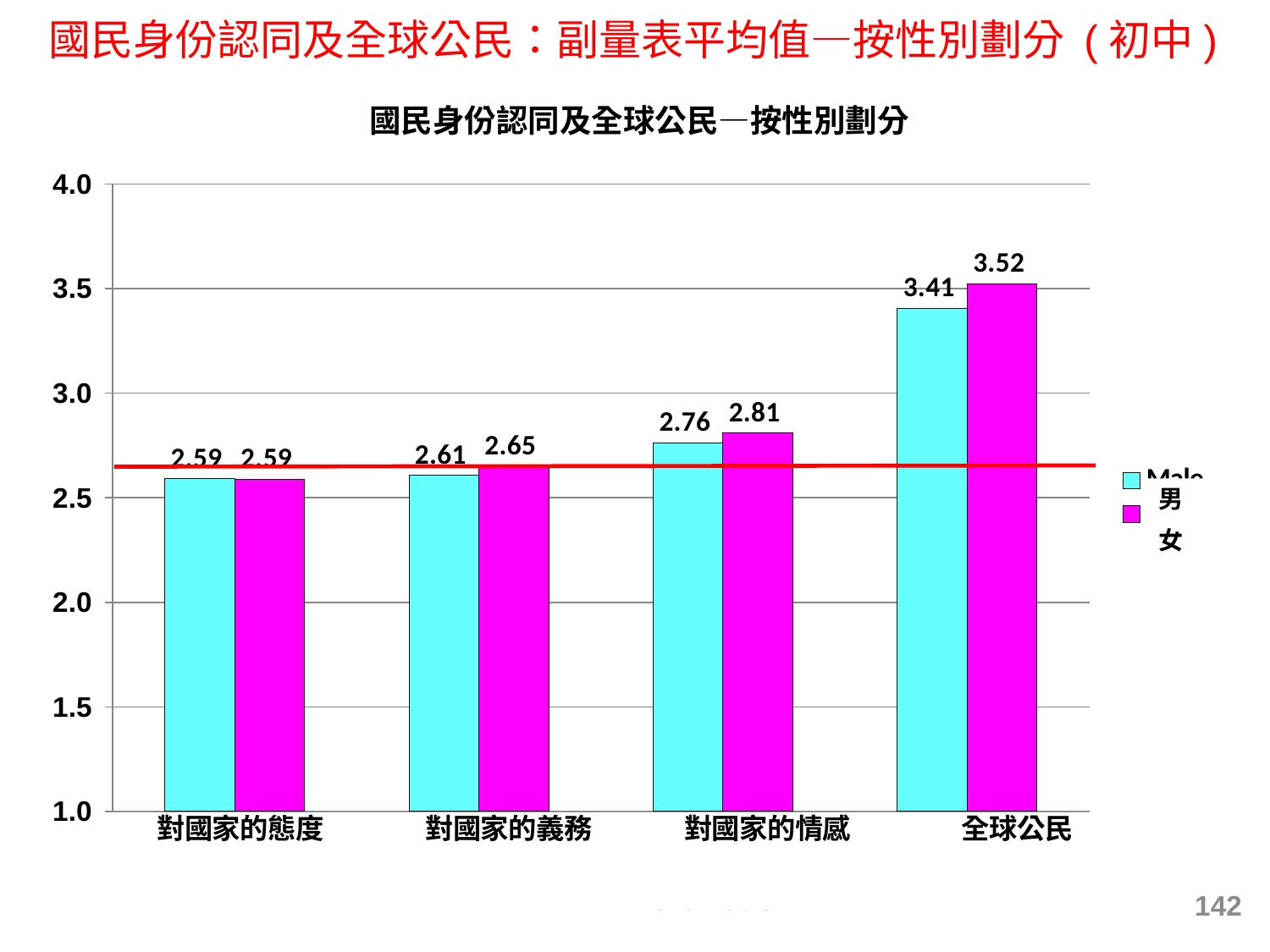
Which category has the highest value for 女? 全球公民 How many series does the legend list? 2 What is the value for 女 in the 對國家的態度 category? 2.59 What is the value for 男 in the 全球公民 category? 3.41 What is the difference between the 女 and 男 values in the 全球公民 category? 0.11 What is the value for 男 in the 對國家的義務 category? 2.61 Which category has the lowest value for 男? 對國家的態度 In the 對國家的情感 category, which is larger, the 男 value or the 女 value? 女 How many categories are shown on the x axis? 4 Do the 男 values rise or fall from 對國家的態度 to 全球公民 along the x axis? rise What kind of chart is shown on the slide? bar chart What is the value for 女 in the 對國家的情感 category? 2.81